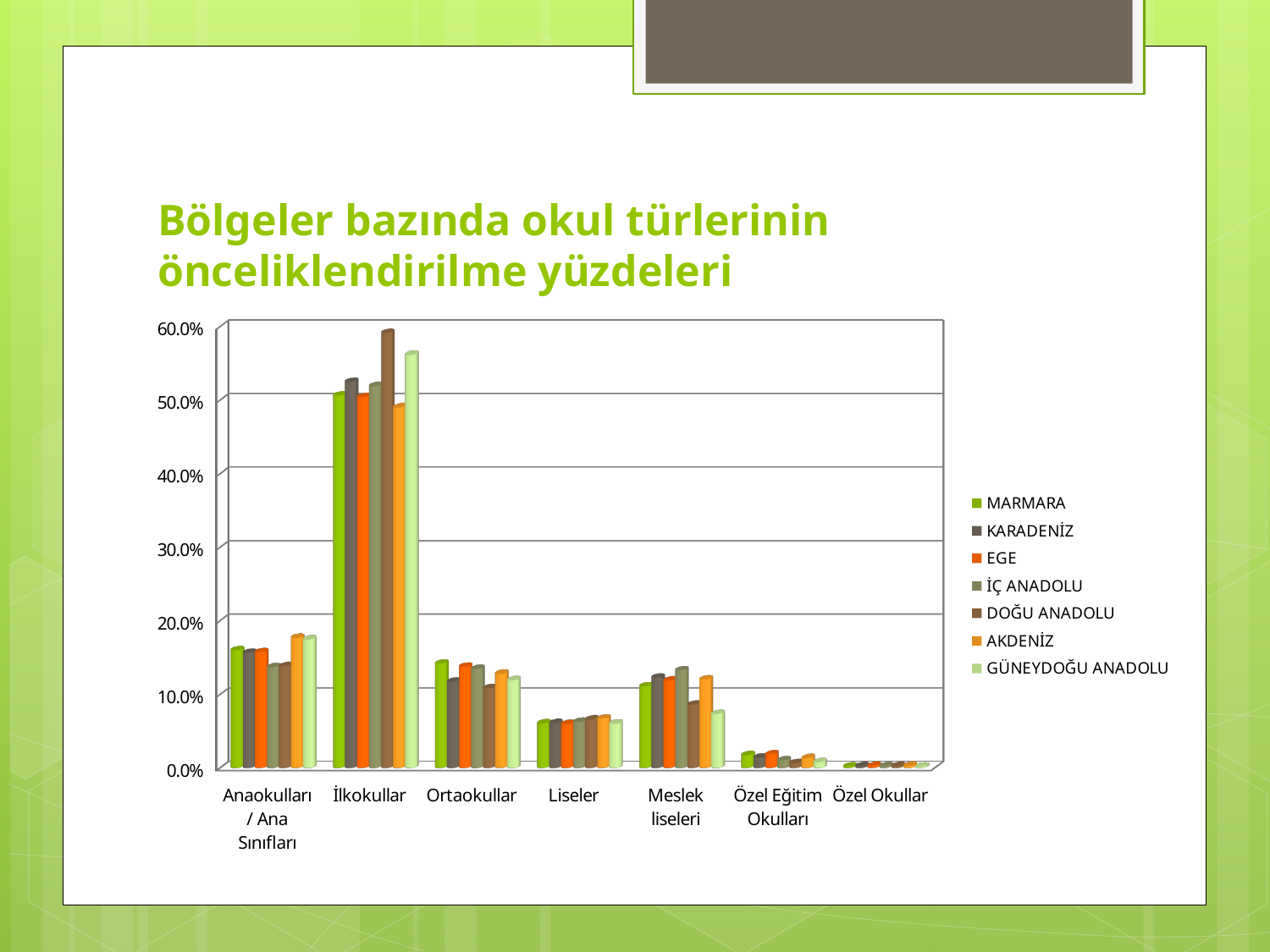
Which is larger for İlkokullar: DOĞU ANADOLU or GÜNEYDOĞU ANADOLU? DOĞU ANADOLU Which region has the highest value for İlkokullar? DOĞU ANADOLU Which school type has the highest prioritisation percentages across the regions? İlkokullar Is the value for MARMARA in Anaokulları / Ana Sınıfları greater or less than 10.0%? greater What kind of chart is shown on the slide? bar chart What is the title of the slide containing the chart? Bölgeler bazında okul türlerinin önceliklendirilme yüzdeleri How many series does the legend list? 7 Is the value for EGE in Liseler greater or less than 10.0%? less Is the value for DOĞU ANADOLU in İlkokullar greater or less than 50.0%? greater How many school-type categories are shown on the x axis? 7 Which school type has the lowest prioritisation percentages across the regions? Özel Okullar Which is larger for Anaokulları / Ana Sınıfları: AKDENİZ or İÇ ANADOLU? AKDENİZ